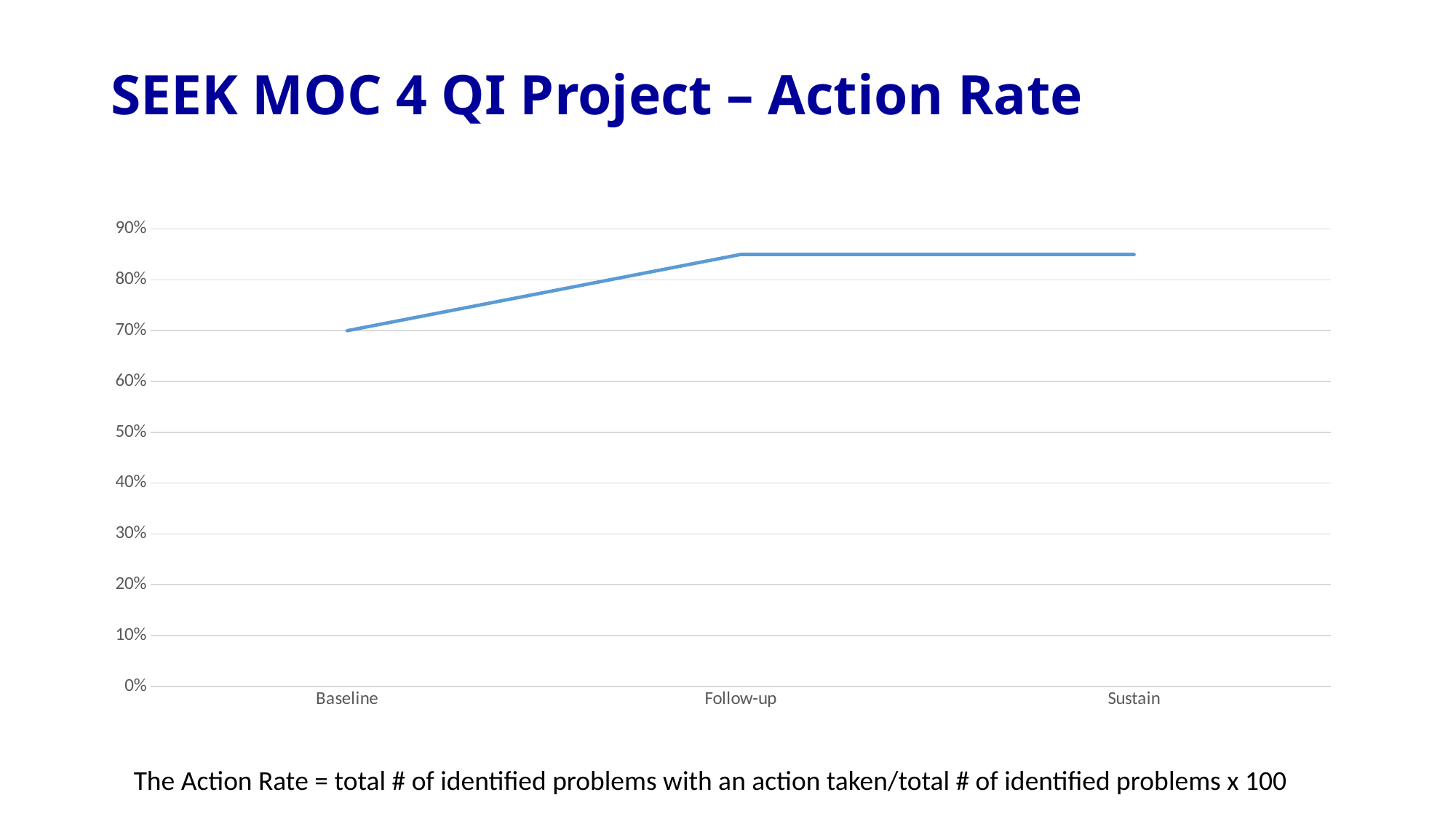
Which category has the lowest value? Baseline Is the value for Follow-up greater or less than 80%? greater Does the line rise or fall from Baseline to Follow-up? rise Is the value for Baseline greater or less than 60%? greater What is the value for Baseline? 70% What is the label of the last category on the x axis? Sustain How many points are plotted on the line? 3 What is the title of the slide containing the chart? SEEK MOC 4 QI Project – Action Rate What kind of chart is shown on the slide? line chart Is the value for Sustain greater or less than 90%? less Which is larger, the value for Baseline or the value for Follow-up? Follow-up